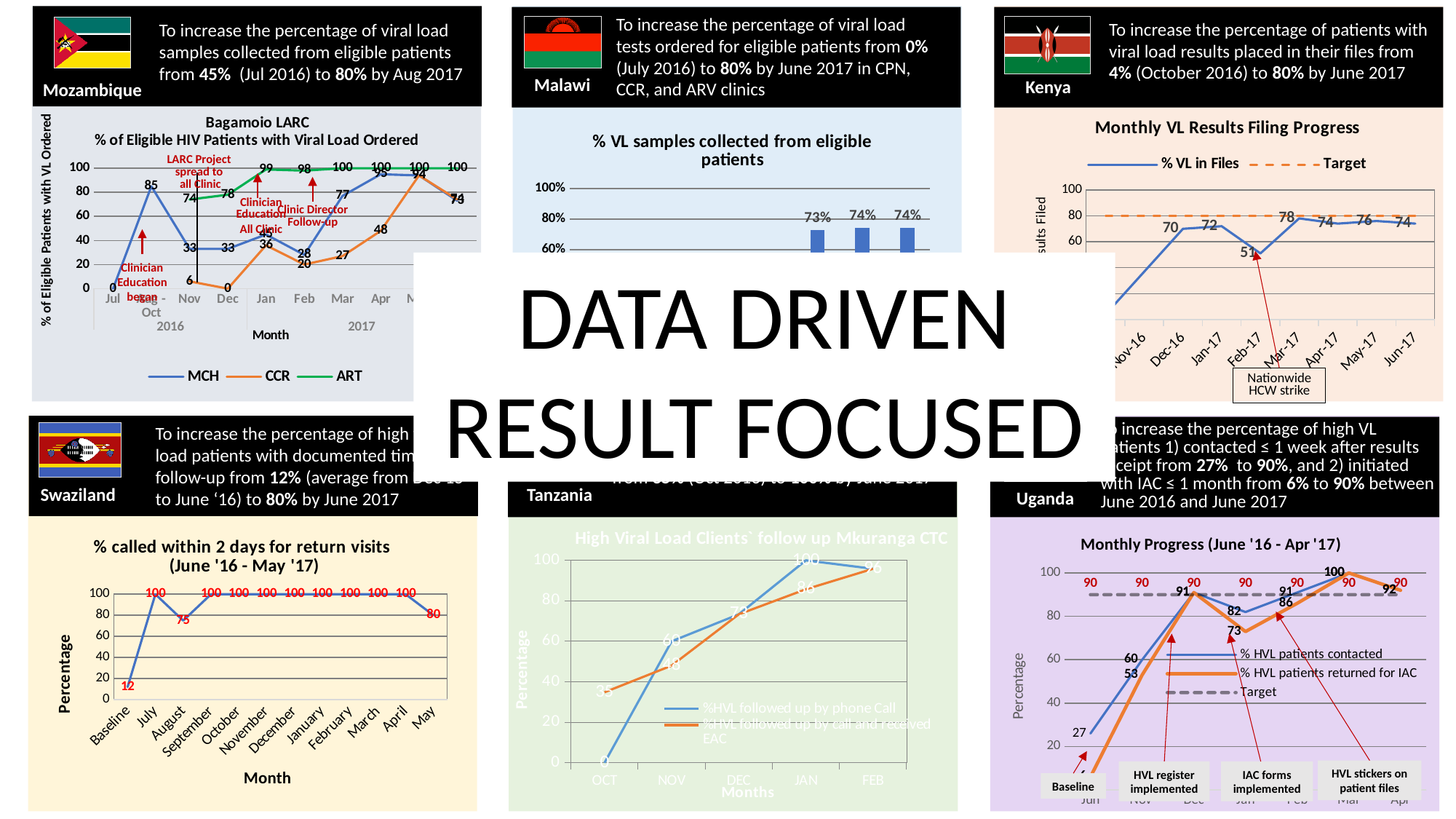
On the Kenya chart 'Monthly VL Results Filing Progress', what is the % VL in Files value for Mar-17? 78 On the Tanzania chart 'High Viral Load Clients` follow up Mkuranga CTC', do the values generally rise or fall from OCT to FEB? rise On the Mozambique chart titled 'Bagamoio LARC % of Eligible HIV Patients with Viral Load Ordered', how many series does the legend list? 3 On the Swaziland chart '% called within 2 days for return visits', which category has the lowest value? Baseline On the Kenya chart 'Monthly VL Results Filing Progress', what is the difference between the Mar-17 and Feb-17 values of % VL in Files? 27 On the Swaziland chart '% called within 2 days for return visits', what is the value for August? 75 On the Swaziland chart '% called within 2 days for return visits', how many data points are plotted along the x axis? 12 What kind of chart is the Malawi chart titled '% VL samples collected from eligible patients'? bar chart On the Kenya chart 'Monthly VL Results Filing Progress', what is the % VL in Files value for Feb-17? 51 On the Uganda chart 'Monthly Progress (June '16 - Apr '17)', what is the value of % HVL patients contacted in Mar? 100 On the Kenya chart 'Monthly VL Results Filing Progress', what event is annotated at the Feb-17 dip? Nationwide HCW strike On the Swaziland chart '% called within 2 days for return visits', what is the value for May? 80